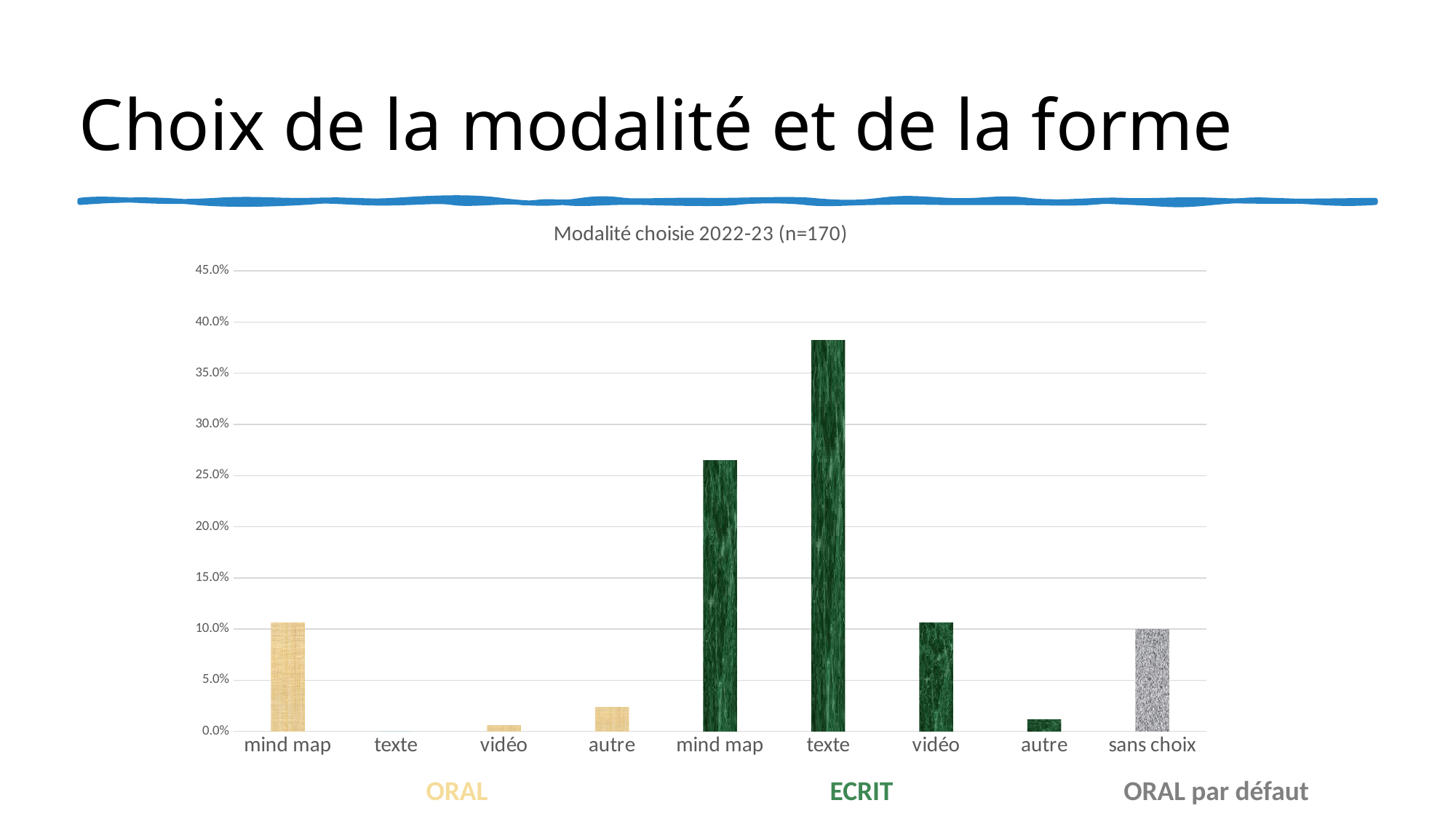
Is the value for mind map in the ECRIT group greater or less than 20.0%? greater What type of chart is shown on the slide? bar chart Is the value for vidéo in the ECRIT group greater or less than 5.0%? greater Is the value for autre in the ORAL group greater or less than 5.0%? less Which is larger: mind map in the ECRIT group or texte in the ECRIT group? texte (ECRIT) Which is larger: mind map in the ORAL group or autre in the ORAL group? mind map (ORAL) What is the title of the chart? Modalité choisie 2022-23 (n=170) How many bars (categories) are plotted in the chart? 9 What are the three group labels shown below the x axis? ORAL, ECRIT, ORAL par défaut Which category has the highest value in the chart? texte (ECRIT) Which category has the lowest value in the chart? texte (ORAL)